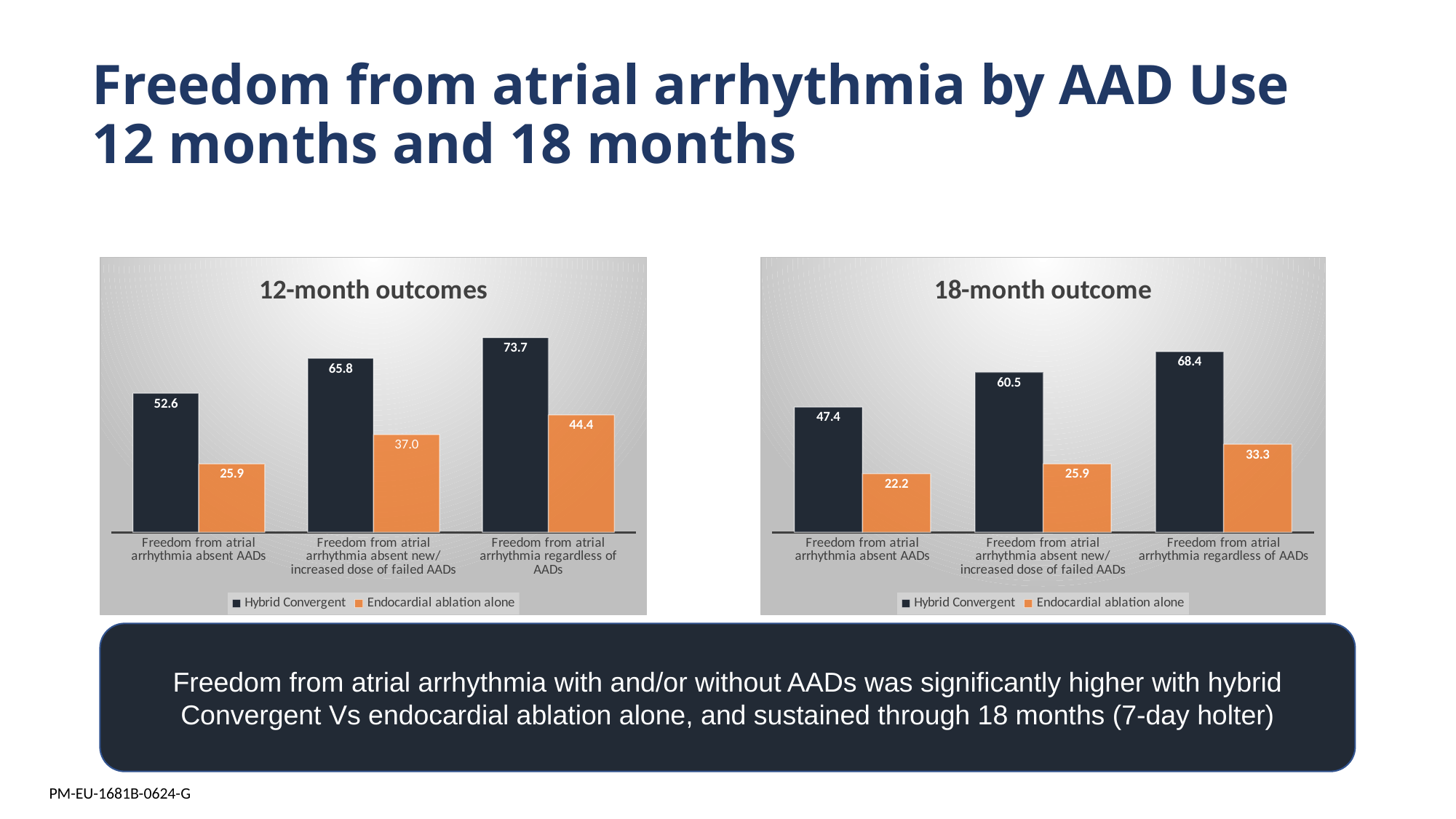
What kind of chart is the 12-month outcomes chart? Bar chart In the 18-month outcome chart, which category has the lowest Endocardial ablation alone value? Freedom from atrial arrhythmia absent AADs In the 12-month outcomes chart, what is the difference between the Hybrid Convergent and Endocardial ablation alone values for freedom from atrial arrhythmia absent new/increased dose of failed AADs? 28.8 In the 18-month outcome chart, which is larger for freedom from atrial arrhythmia absent AADs: Hybrid Convergent or Endocardial ablation alone? Hybrid Convergent In the 12-month outcomes chart, what is the value for Hybrid Convergent for freedom from atrial arrhythmia absent AADs? 52.6 In the 18-month outcome chart, what is the value for Endocardial ablation alone for freedom from atrial arrhythmia absent AADs? 22.2 In the 18-month outcome chart, what is the value for Hybrid Convergent for freedom from atrial arrhythmia absent new/increased dose of failed AADs? 60.5 In the 12-month outcomes chart, what is the value for Endocardial ablation alone for freedom from atrial arrhythmia regardless of AADs? 44.4 How many series does the legend of the 18-month outcome chart list? 2 In the 18-month outcome chart, what is the difference between the Hybrid Convergent and Endocardial ablation alone values for freedom from atrial arrhythmia regardless of AADs? 35.1 How many categories are shown on the x axis of the 12-month outcomes chart? 3 In the 12-month outcomes chart, which category has the highest Hybrid Convergent value? Freedom from atrial arrhythmia regardless of AADs